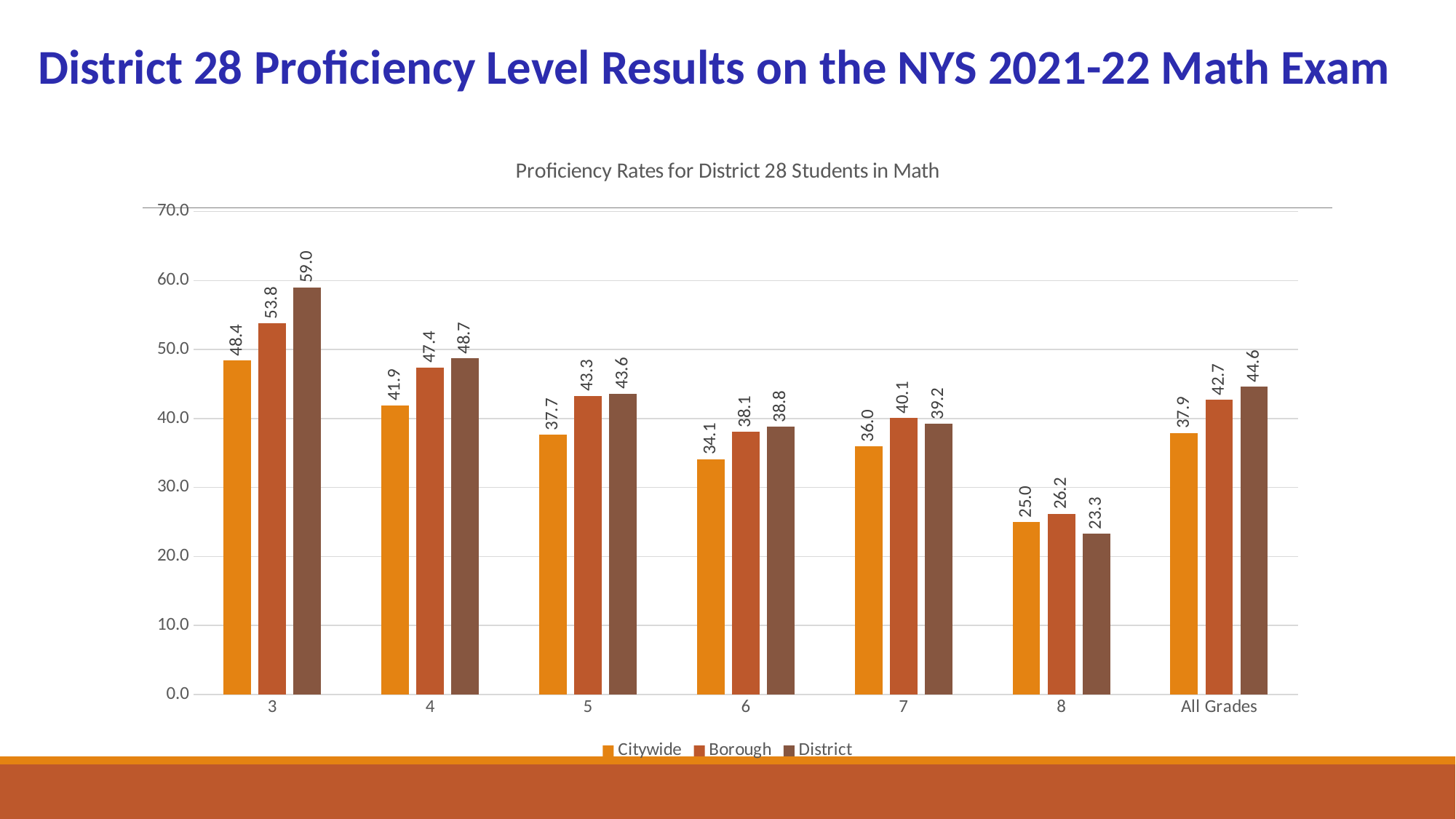
Which grade has the highest District proficiency rate? 3 What is the Borough proficiency rate for All Grades? 42.7 What is the District proficiency rate for grade 3? 59.0 Which is larger for grade 8, the Borough rate or the District rate? Borough How many series does the legend list? 3 Which grade has the lowest Citywide proficiency rate? 8 What is the Citywide proficiency rate for grade 6? 34.1 What kind of chart is shown on the slide? Bar chart What is the title of the chart? Proficiency Rates for District 28 Students in Math How many categories are shown on the x axis? 7 Is the Citywide value for grade 4 greater or less than 40.0? greater What is the difference between the District and Citywide proficiency rates for grade 3? 10.6